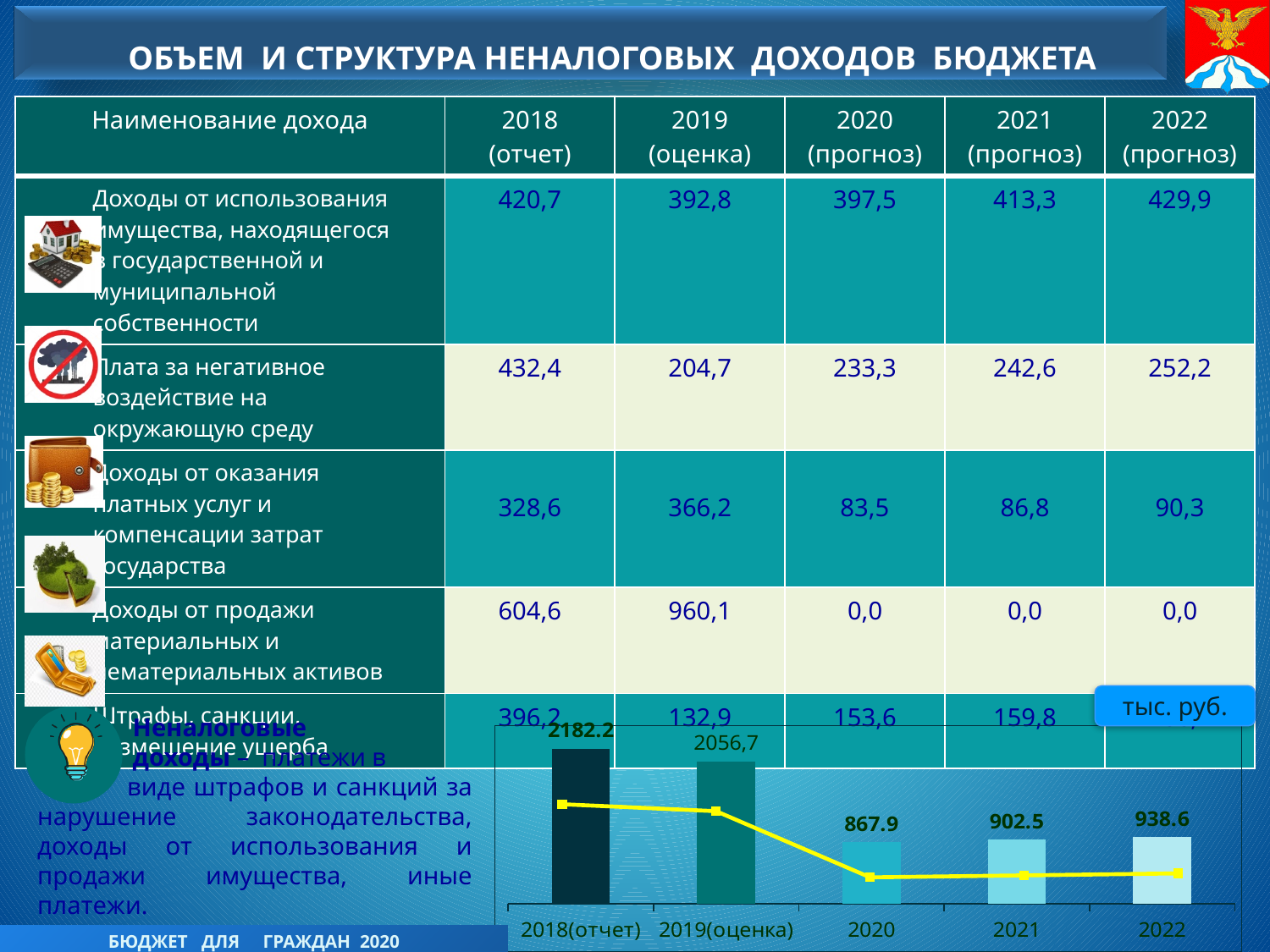
In the chart at the bottom of the slide, what is the difference between the values for 2018(отчет) and 2019(оценка)? 125.5 In the chart at the bottom of the slide, what is the difference between the values for 2022 and 2020? 70.7 How many categories are shown on the x axis of the chart at the bottom of the slide? 5 In the chart at the bottom of the slide, what is the value for 2019(оценка)? 2056,7 In the chart at the bottom of the slide, which category has the lowest value? 2020 In the chart at the bottom of the slide, what is the value for 2018(отчет)? 2182.2 In the chart at the bottom of the slide, which is larger, the value for 2021 or the value for 2022? 2022 In the chart at the bottom of the slide, do the bar values rise or fall from 2018(отчет) to 2020? fall In the chart at the bottom of the slide, what is the value for 2022? 938.6 What unit is shown in the label next to the chart at the bottom of the slide? тыс. руб. In the chart at the bottom of the slide, what is the value for 2020? 867.9 In the chart at the bottom of the slide, which category has the highest value? 2018(отчет)